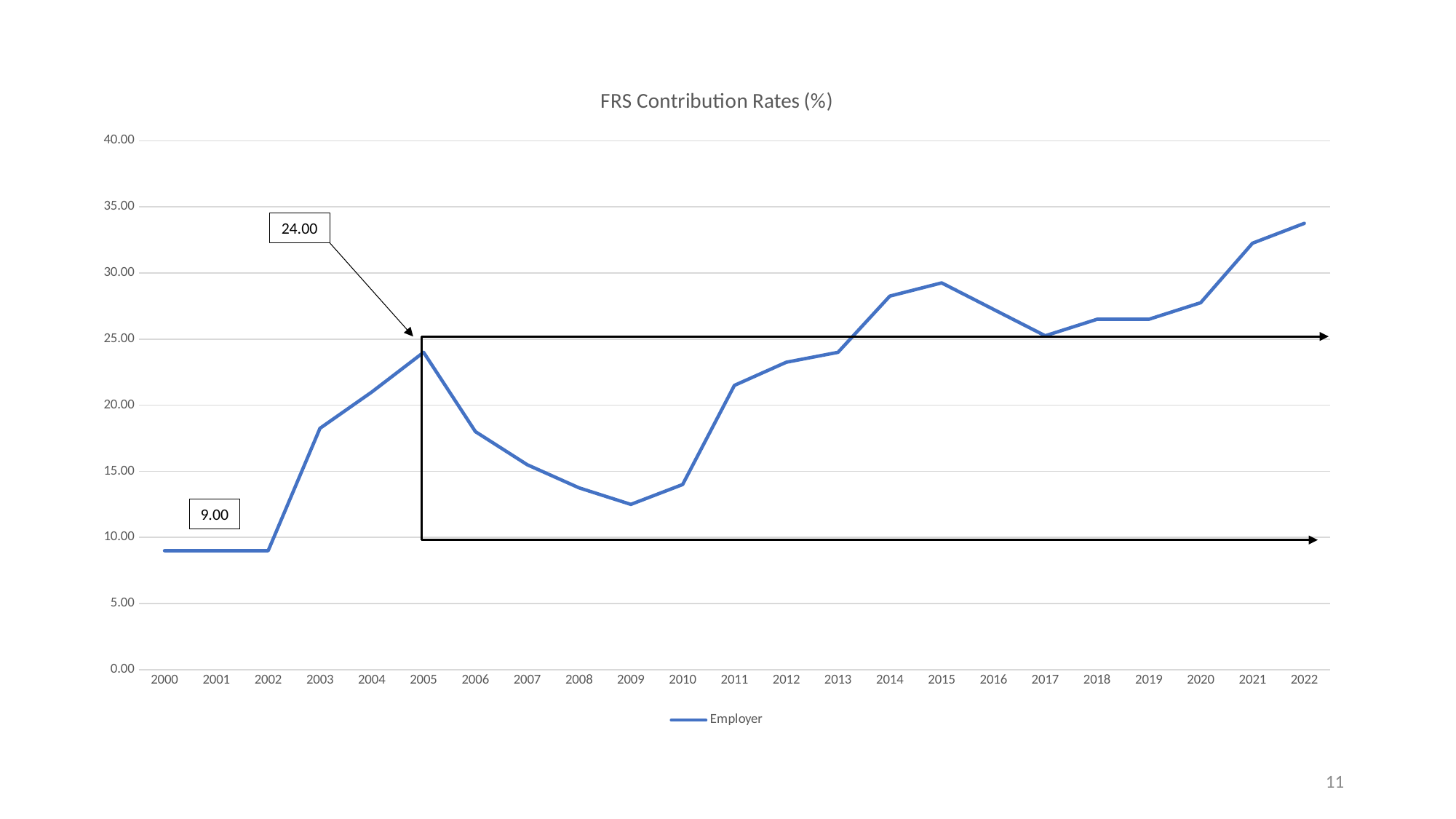
Is the value for 2021 greater or less than 30.00? greater How many series does the legend list? 1 What is the title of the chart? FRS Contribution Rates (%) What is the name of the series shown in the legend? Employer Do the values rise or fall from 2005 to 2009? fall What is the Employer contribution rate labelled for 2005? 24.00 Is the value for 2009 greater or less than 15.00? less What is the Employer contribution rate labelled for 2000? 9.00 Which year has the larger value, 2015 or 2017? 2015 What kind of chart is shown on the slide? line chart Which year has the highest Employer contribution rate? 2022 How many years are plotted along the x axis? 23